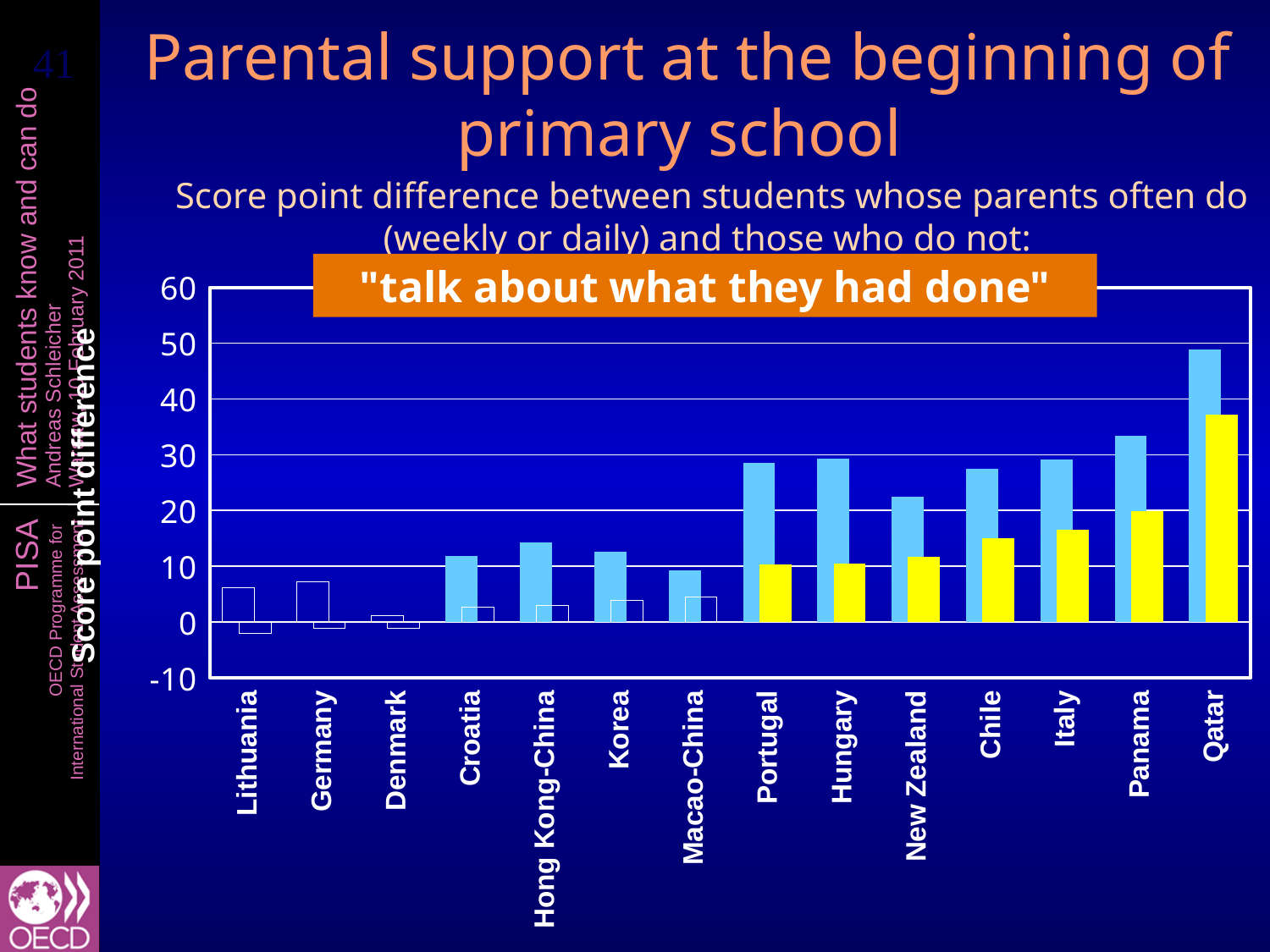
What is the label on the y axis of the chart? Score point difference Which has the larger light blue bar, Qatar or Panama? Qatar Is the light blue bar for Panama greater or less than 30? greater How many countries are shown on the x axis of the chart? 14 Which country has the tallest yellow bar in the chart? Qatar Is the yellow bar for Qatar greater or less than 30? greater Do the light blue bars generally rise or fall from Lithuania on the left to Qatar on the right? rise What kind of chart is shown on the slide? bar chart Which country has the highest light blue bar in the chart? Qatar Is the light blue bar for Qatar greater or less than 40? greater